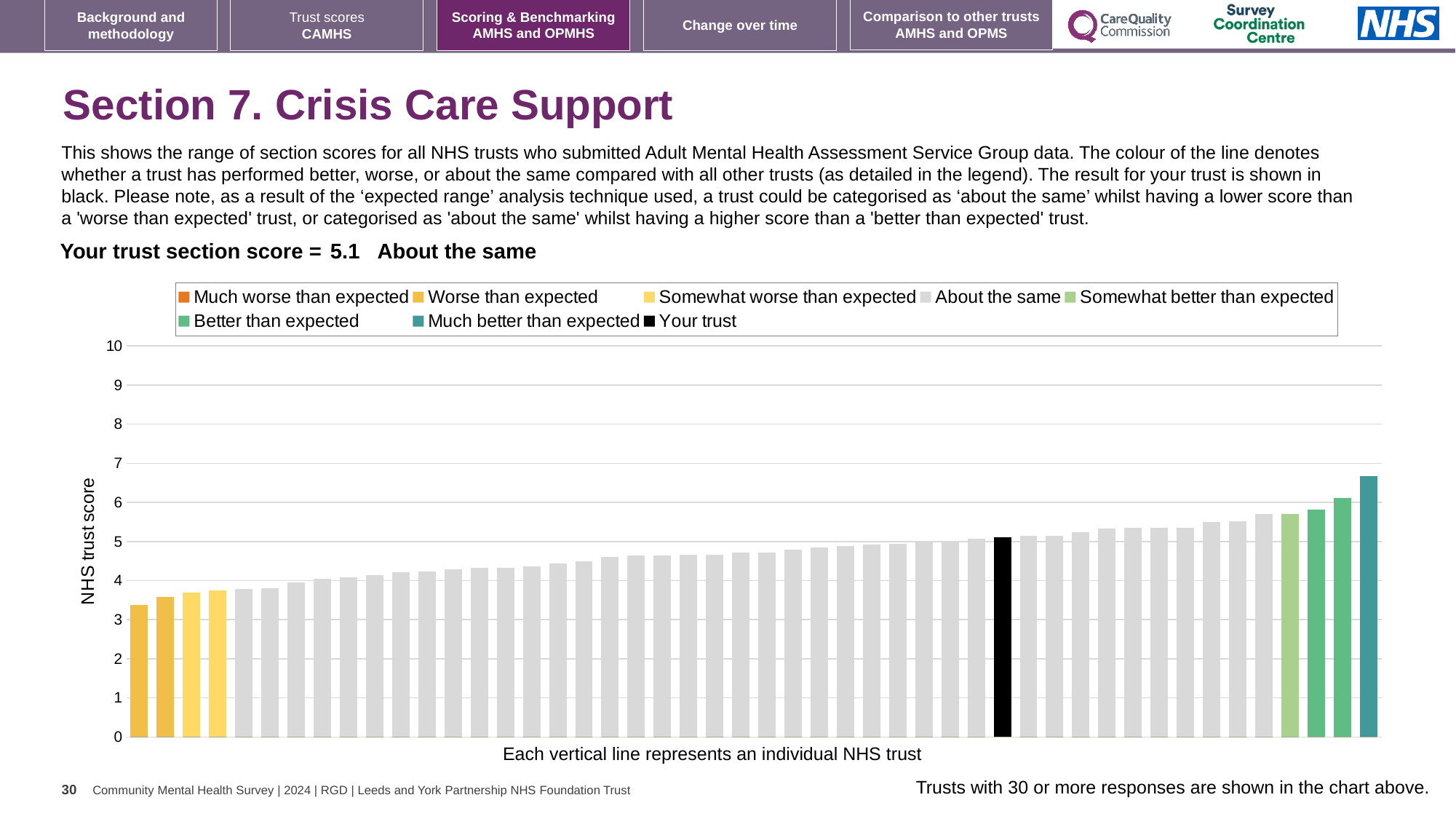
Which legend category does the tallest bar belong to? Much better than expected Do the bar values rise or fall from left to right along the x axis? rise Is the black bar for your trust taller or shorter than the leftmost bar? taller How many entries does the chart legend list? 8 What is the section score for your trust shown on the slide? 5.1 What kind of chart is shown on the slide? bar chart What is the highest tick value shown on the vertical axis? 10 Which category is your trust's section score placed in? About the same Is the value of the shortest bar greater or less than 4? less What is the label on the vertical axis of the chart? NHS trust score Is the value of the tallest bar greater or less than 6? greater